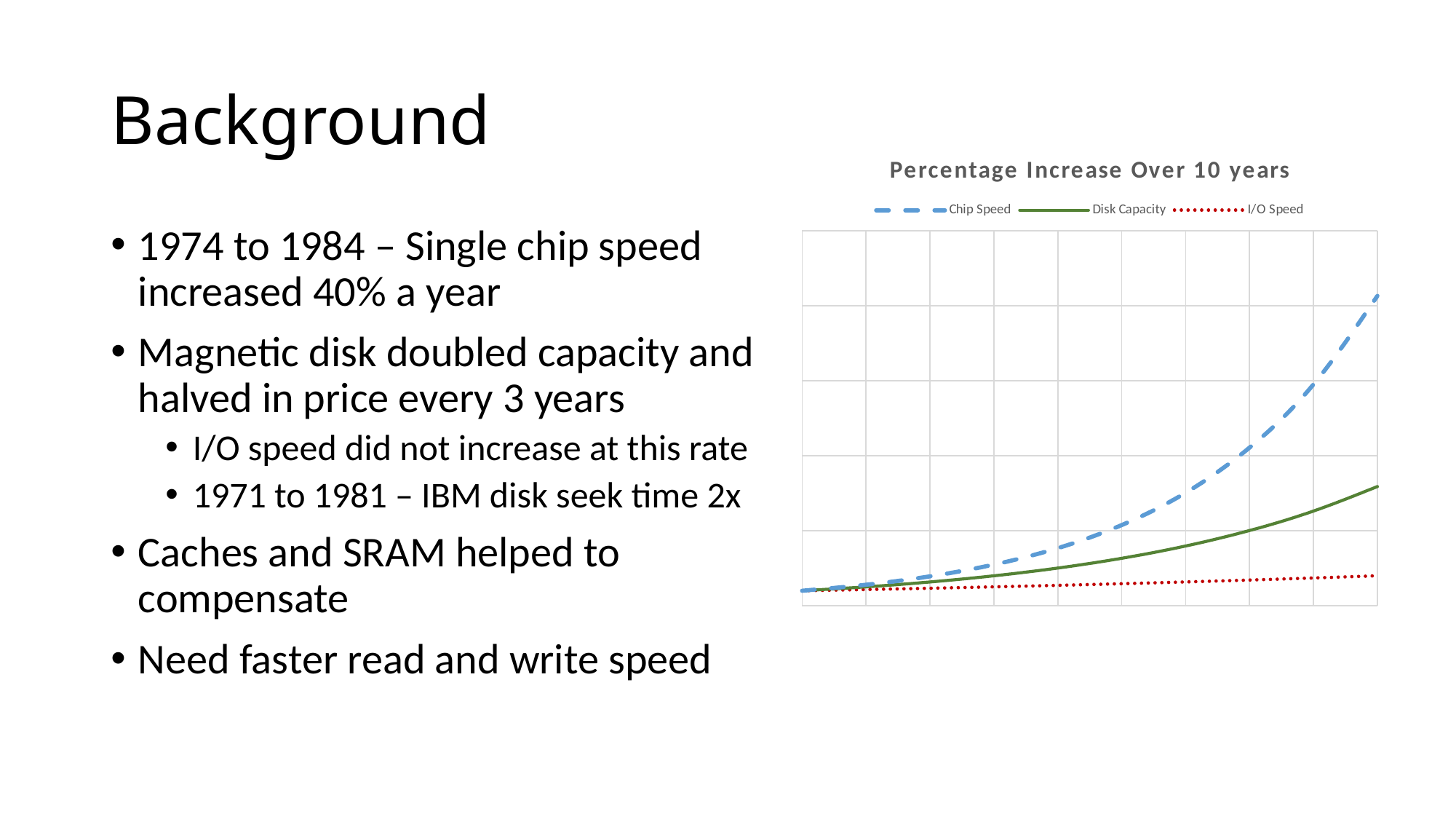
What is the title of the chart? Percentage Increase Over 10 years At the right end of the chart, which is larger: Chip Speed or Disk Capacity? Chip Speed At the right end of the chart, which is larger: Disk Capacity or I/O Speed? Disk Capacity What kind of chart is shown on the slide? Line chart Does the Disk Capacity line rise or fall from left to right? Rise Does the Chip Speed line rise or fall from left to right? Rise How many series does the chart's legend list? 3 Which series in the chart is drawn with a red dotted line? I/O Speed Which series has the lowest value at the right end of the chart? I/O Speed Which series reaches the highest value at the right end of the chart? Chip Speed Which series shows the slowest growth across the chart? I/O Speed